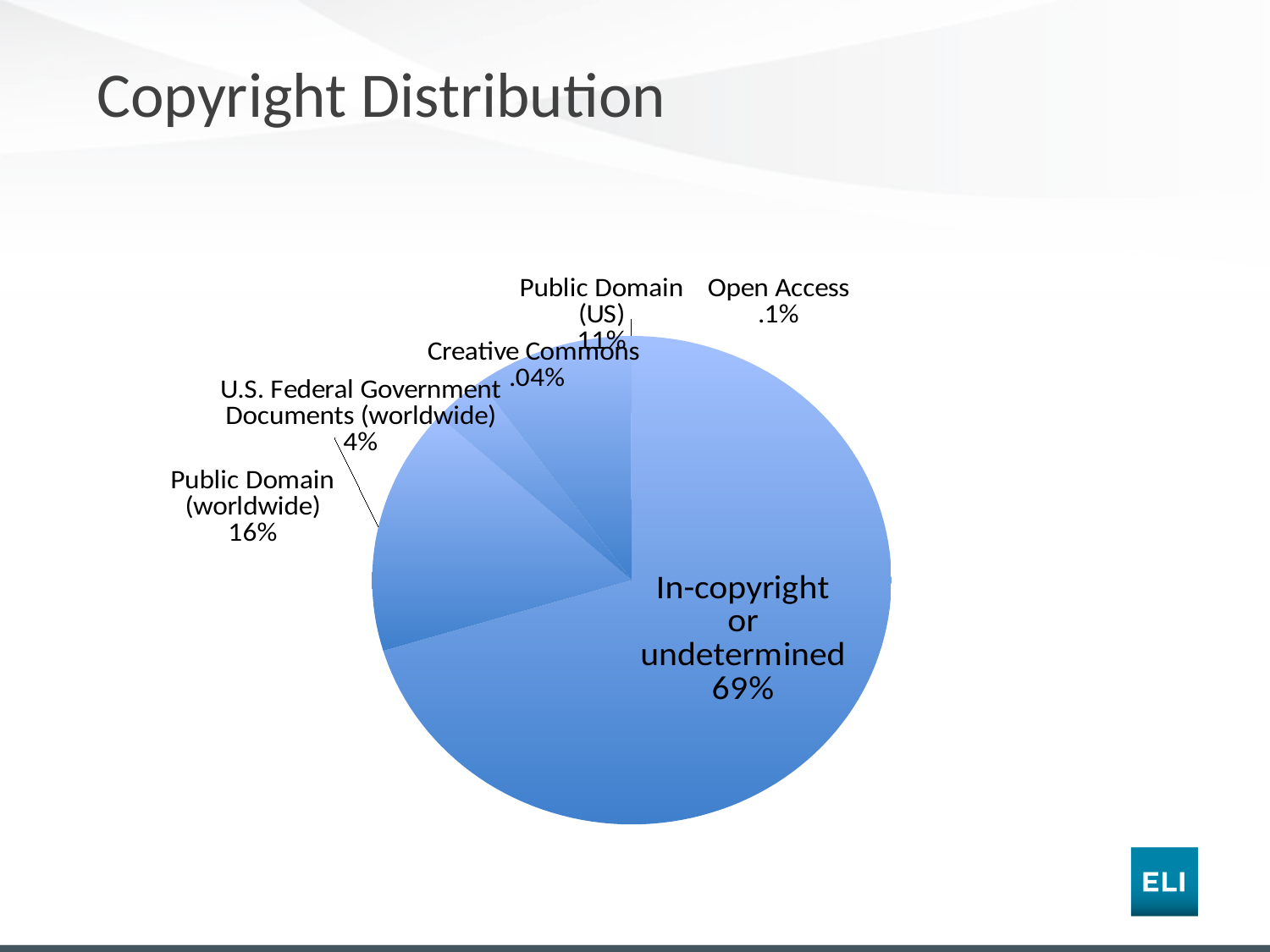
What share of the pie is Creative Commons? .04% What kind of chart is shown on the slide? pie chart How many slices does the pie chart have? 6 Which category has the largest slice of the pie? In-copyright or undetermined What share of the pie is U.S. Federal Government Documents (worldwide)? 4% What share of the pie is Open Access? .1% Which category has the smallest slice of the pie? Creative Commons What is the title of the chart? Copyright Distribution What is the difference in percentage points between Public Domain (worldwide) and Public Domain (US)? 5%